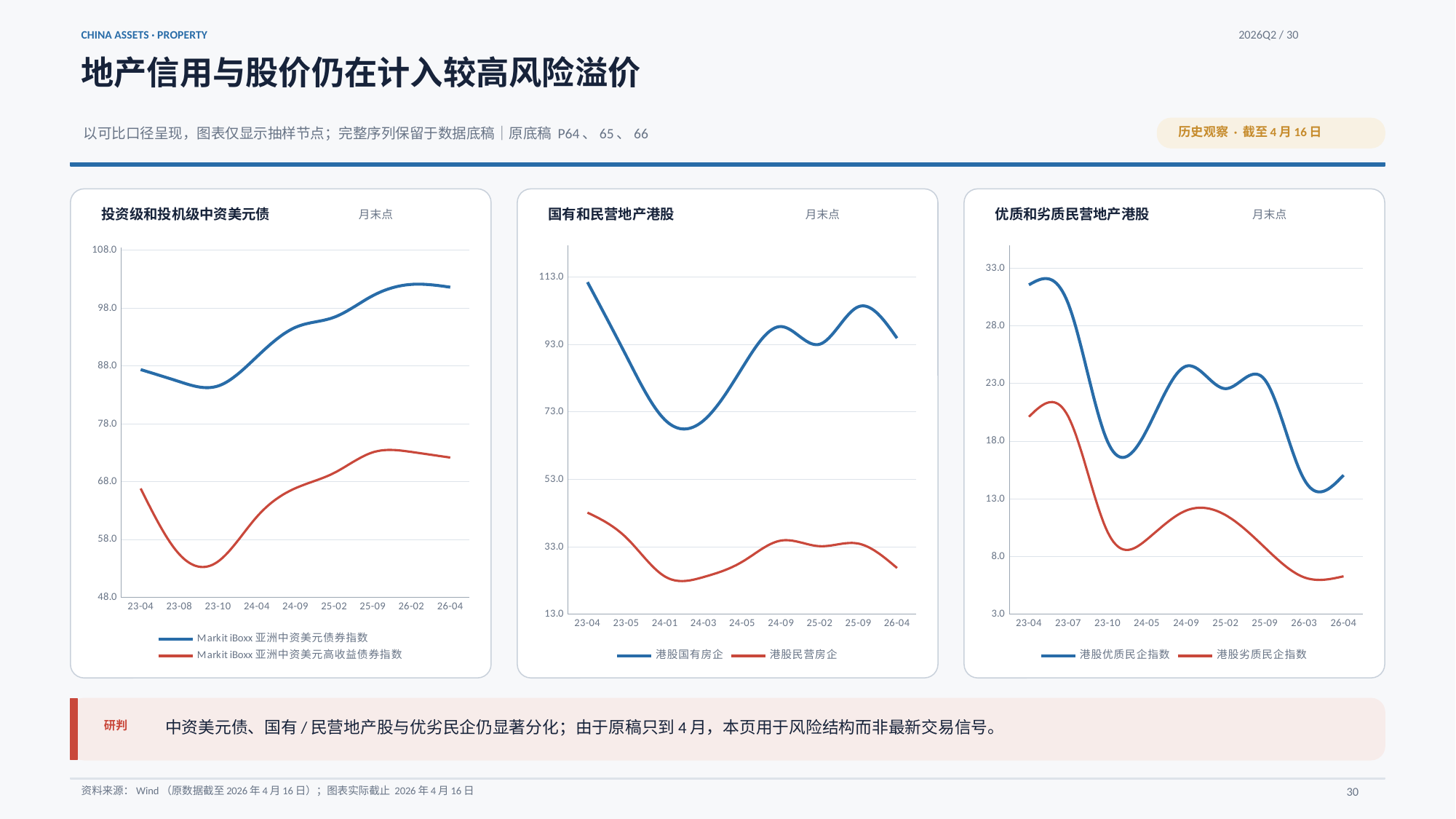
In the left chart (投资级和投机级中资美元债), is the value of Markit iBoxx 亚洲中资美元债券指数 at 26-02 greater or less than 98.0? greater What kind of chart is the left chart titled 投资级和投机级中资美元债? line chart How many series does the legend of the left chart (投资级和投机级中资美元债) list? 2 In the right chart (优质和劣质民营地产港股), at which x-axis point is the 港股劣质民企指数 line lowest? 26-03 In the middle chart (国有和民营地产港股), at which x-axis point is the 港股国有房企 line highest? 23-04 In the right chart (优质和劣质民营地产港股), is the value of 港股劣质民企指数 at 26-03 greater or less than 8.0? less What colour is the 港股民营房企 line in the middle chart (国有和民营地产港股)? red In the right chart (优质和劣质民营地产港股), does the 港股优质民企指数 line rise or fall from 23-07 to 23-10? fall In the middle chart (国有和民营地产港股), which series has the larger value at 26-04, 港股国有房企 or 港股民营房企? 港股国有房企 How many x-axis points are shown on the middle chart (国有和民营地产港股)? 9 In the left chart (投资级和投机级中资美元债), is the value of Markit iBoxx 亚洲中资美元高收益债券指数 at 23-10 greater or less than 58.0? less